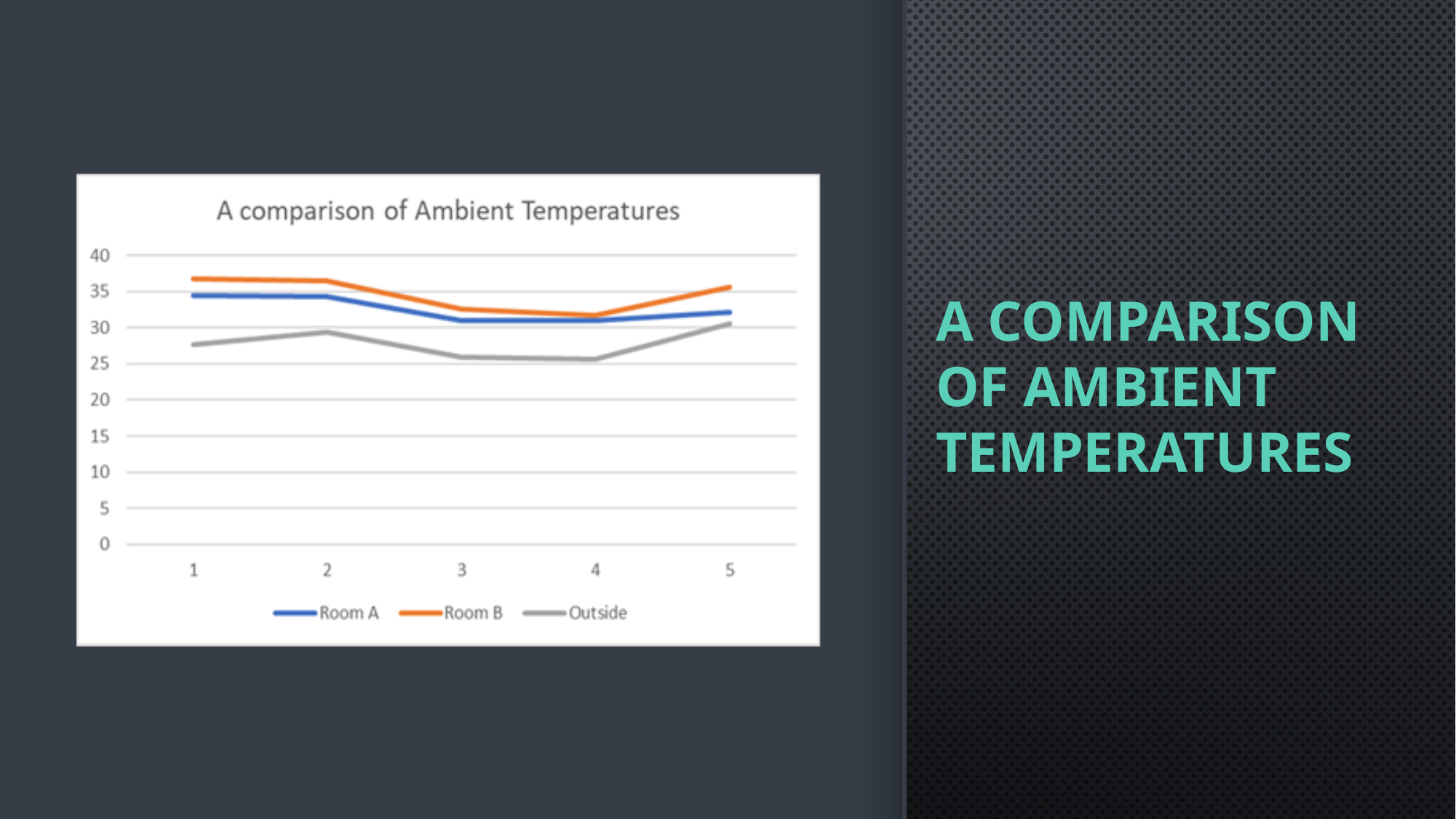
How many points are plotted along the x axis for each series? 5 At point 1, which is higher, Room A or Room B? Room B What kind of chart is shown on the slide? Line chart Does the Outside series rise or fall from point 2 to point 4? Fall Which series has the lowest values across all five points? Outside Is the value for Outside at point 4 greater or less than 30? less What is the title of the chart? A comparison of Ambient Temperatures Is the value for Room A at point 1 greater or less than 30? greater Which series is drawn in orange? Room B Is the value for Room B at point 1 greater or less than 35? greater Which series has the highest value at point 5? Room B How many series does the legend list? 3